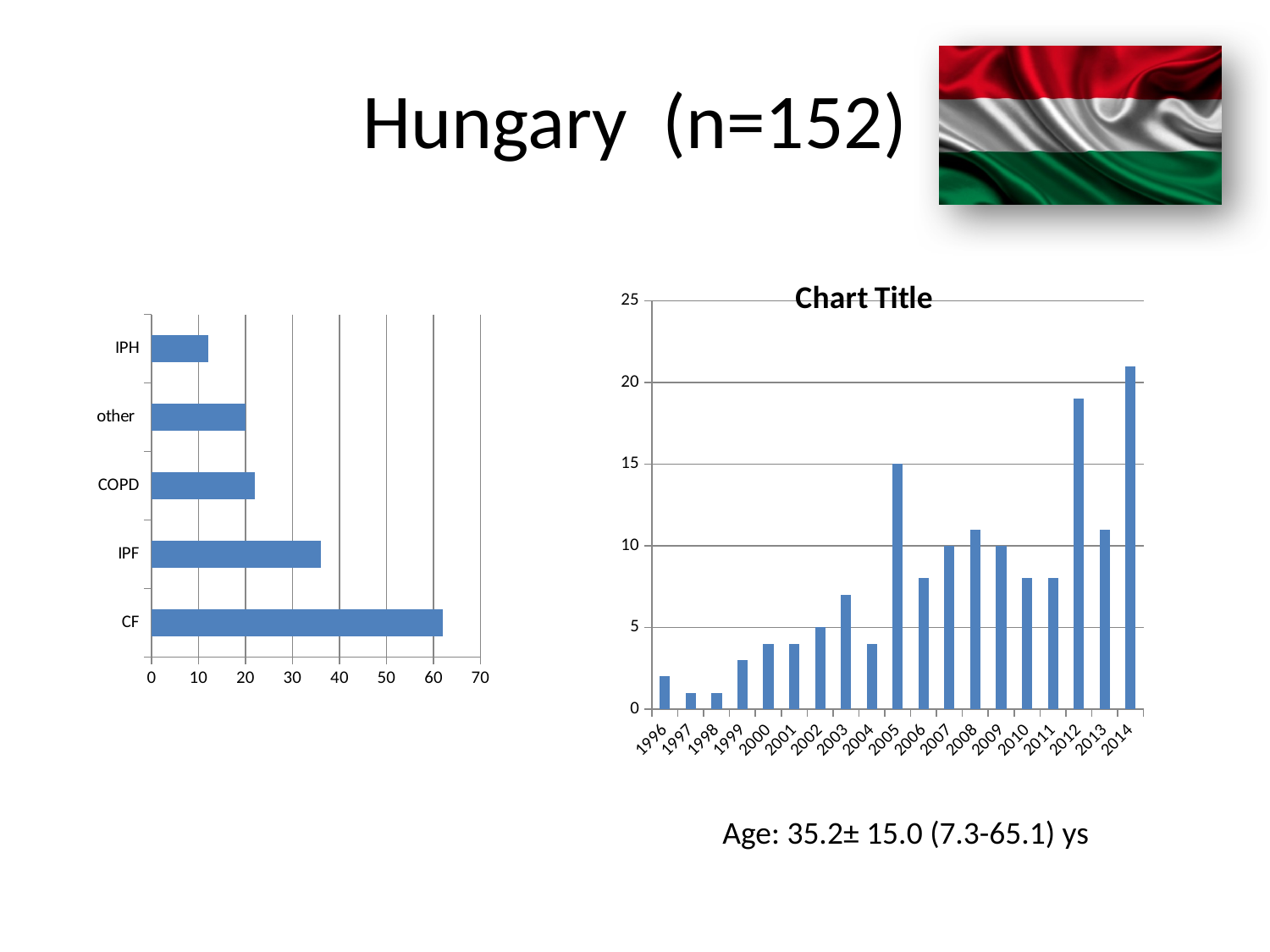
How many categories does the left chart show? 5 On the left chart, which is larger, the value for IPF or the value for COPD? IPF How many years are shown on the x axis of the chart titled 'Chart Title'? 19 On the left chart, is the value for IPH greater or less than 20? less On the left chart, which category has the shortest bar? IPH On the chart titled 'Chart Title', which is larger, the value for 2005 or the value for 2006? 2005 On the left chart, which category has the longest bar? CF On the chart titled 'Chart Title', which year has the highest bar? 2014 On the left chart, is the value for CF greater or less than 60? greater On the left chart, is the value for IPF greater or less than 30? greater What kind of chart is the left chart? bar chart